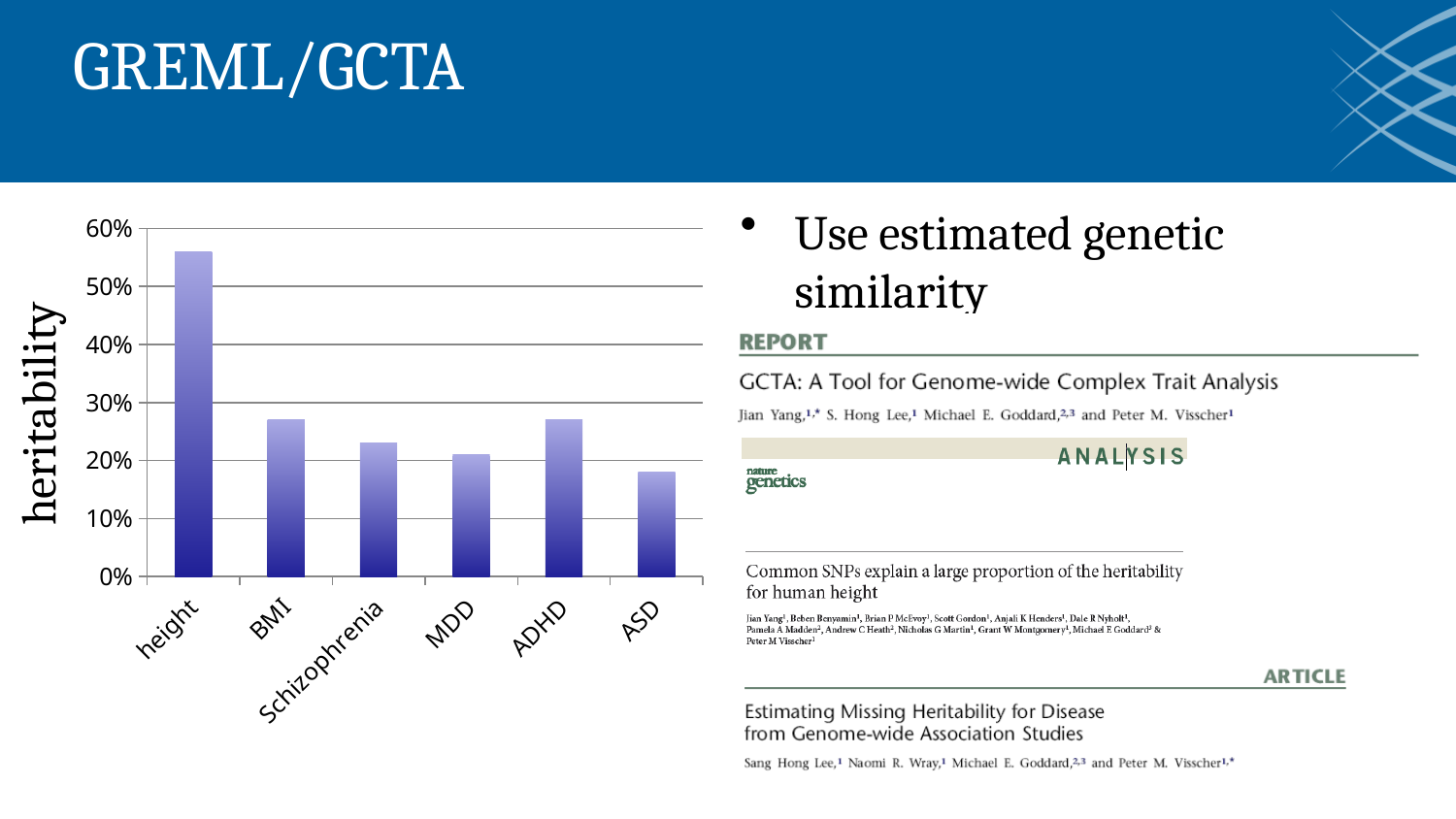
Is the heritability value for height greater or less than 50%? greater Is the heritability value for ADHD greater or less than 30%? less What is the label on the y axis of the chart? heritability Which category has the lowest heritability in the chart? ASD Which has the larger heritability, ADHD or ASD? ADHD Is the heritability value for ASD greater or less than 20%? less Which has the larger heritability, height or BMI? height What kind of chart is shown on the slide? bar chart Which category has the highest heritability in the chart? height How many categories are shown on the x axis of the chart? 6